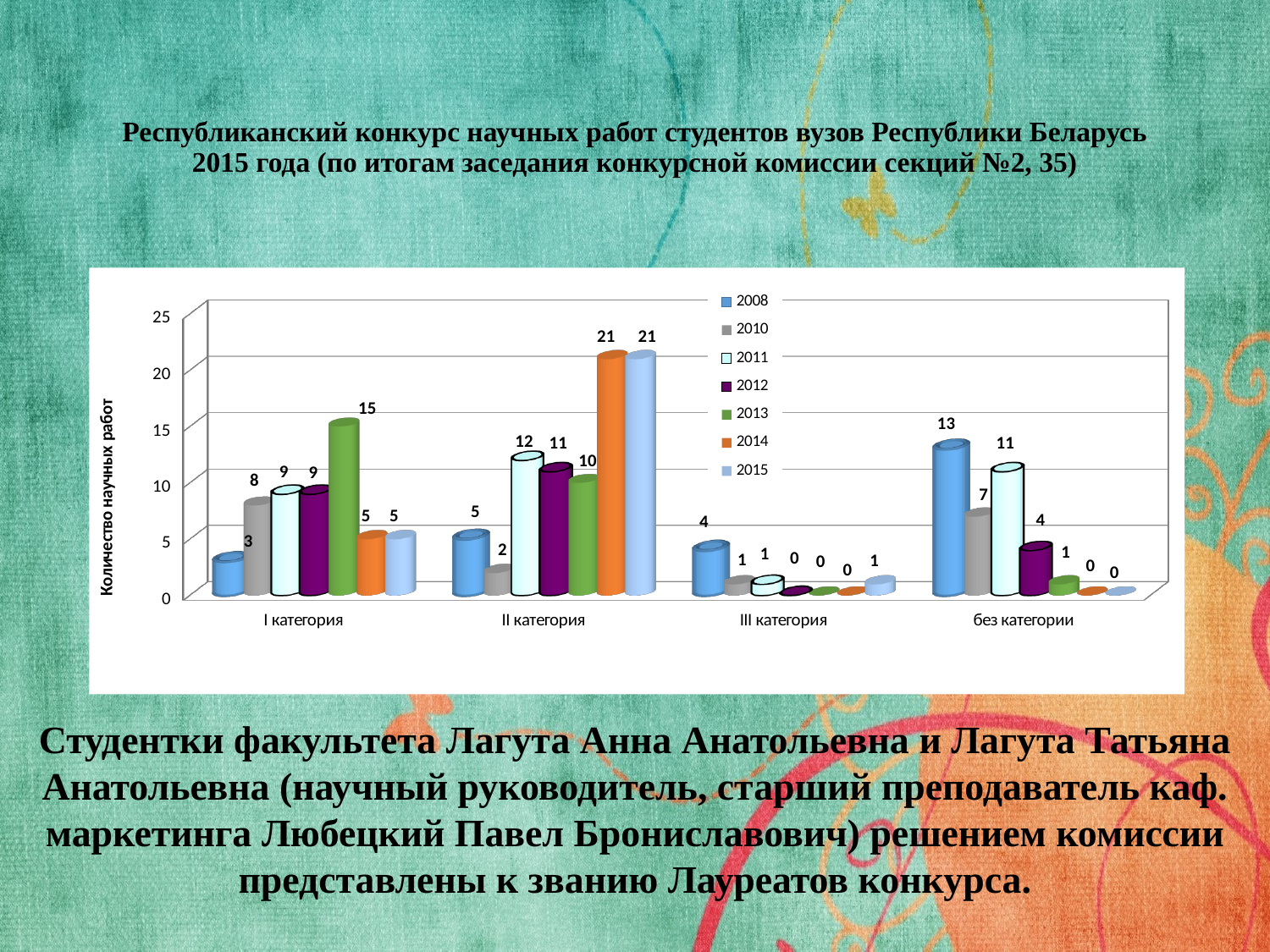
What type of chart is shown on the slide? bar chart What is the value for 2013 in the 'I категория' group? 15 Which is larger in the 'без категории' group: the value for 2010 or the value for 2011? 2011 What is the label of the vertical axis? Количество научных работ How many series does the legend list? 7 What is the value for 2014 in the 'II категория' group? 21 What is the value for 2012 in the 'III категория' group? 0 What is the difference between the 2011 and 2008 values in the 'II категория' group? 7 Which series has the lowest value in the 'II категория' group? 2010 Which series has the highest value in the 'I категория' group? 2013 What is the value for 2008 in the 'без категории' group? 13 How many categories are shown on the x axis? 4